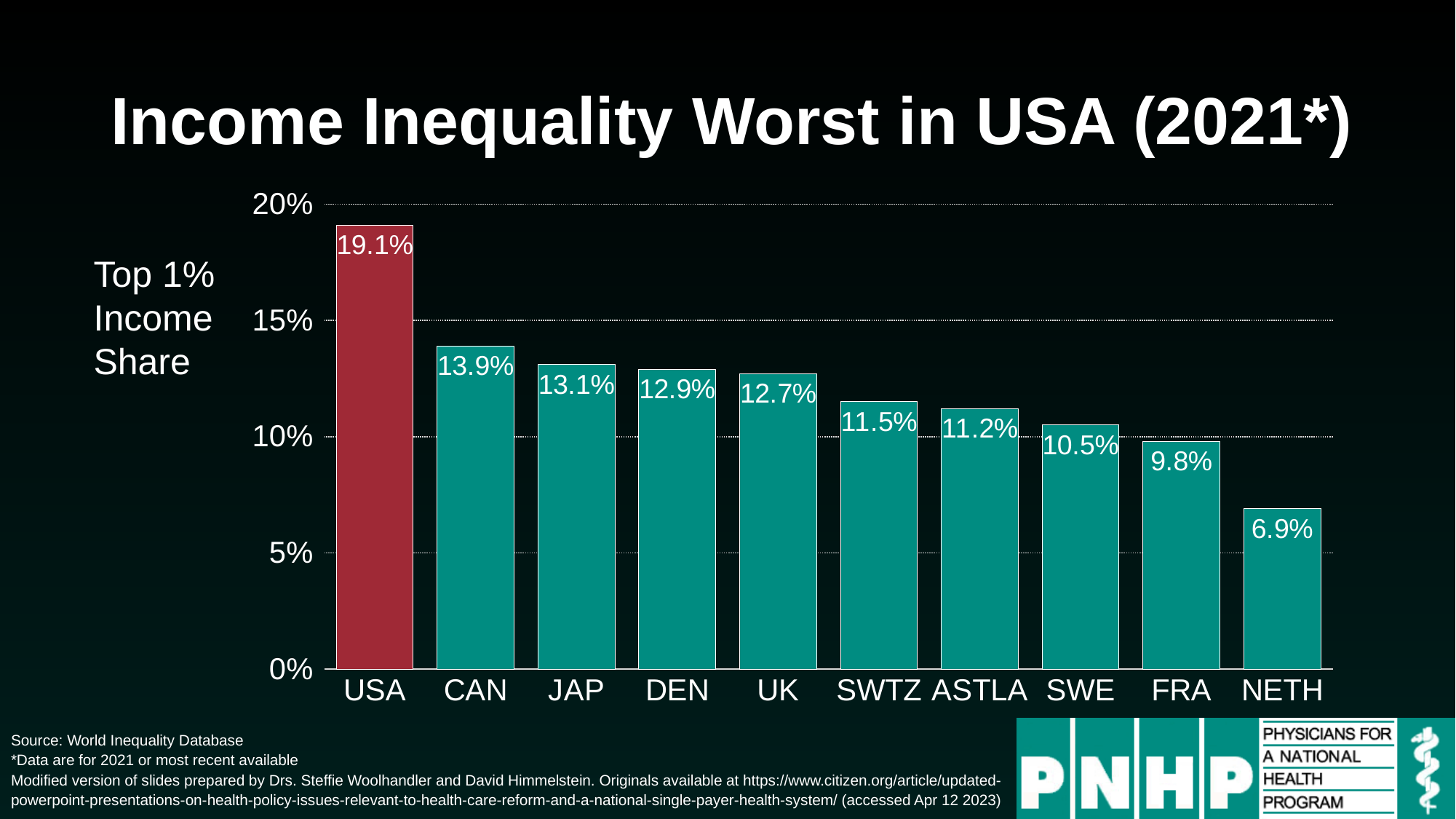
What is the difference between the top 1% income share of FRA and NETH? 2.9% How many countries are shown in the chart? 10 What is the top 1% income share for NETH? 6.9% What is the top 1% income share for the USA? 19.1% What is the difference between the top 1% income share of the USA and CAN? 5.2% Which country has the highest top 1% income share? USA What is the top 1% income share for CAN? 13.9% Is the value for SWTZ greater or less than 10%? greater Which bar is coloured differently from the others? USA Which has a larger top 1% income share, JAP or SWE? JAP What kind of chart is shown on the slide? Bar chart Which country has the lowest top 1% income share? NETH